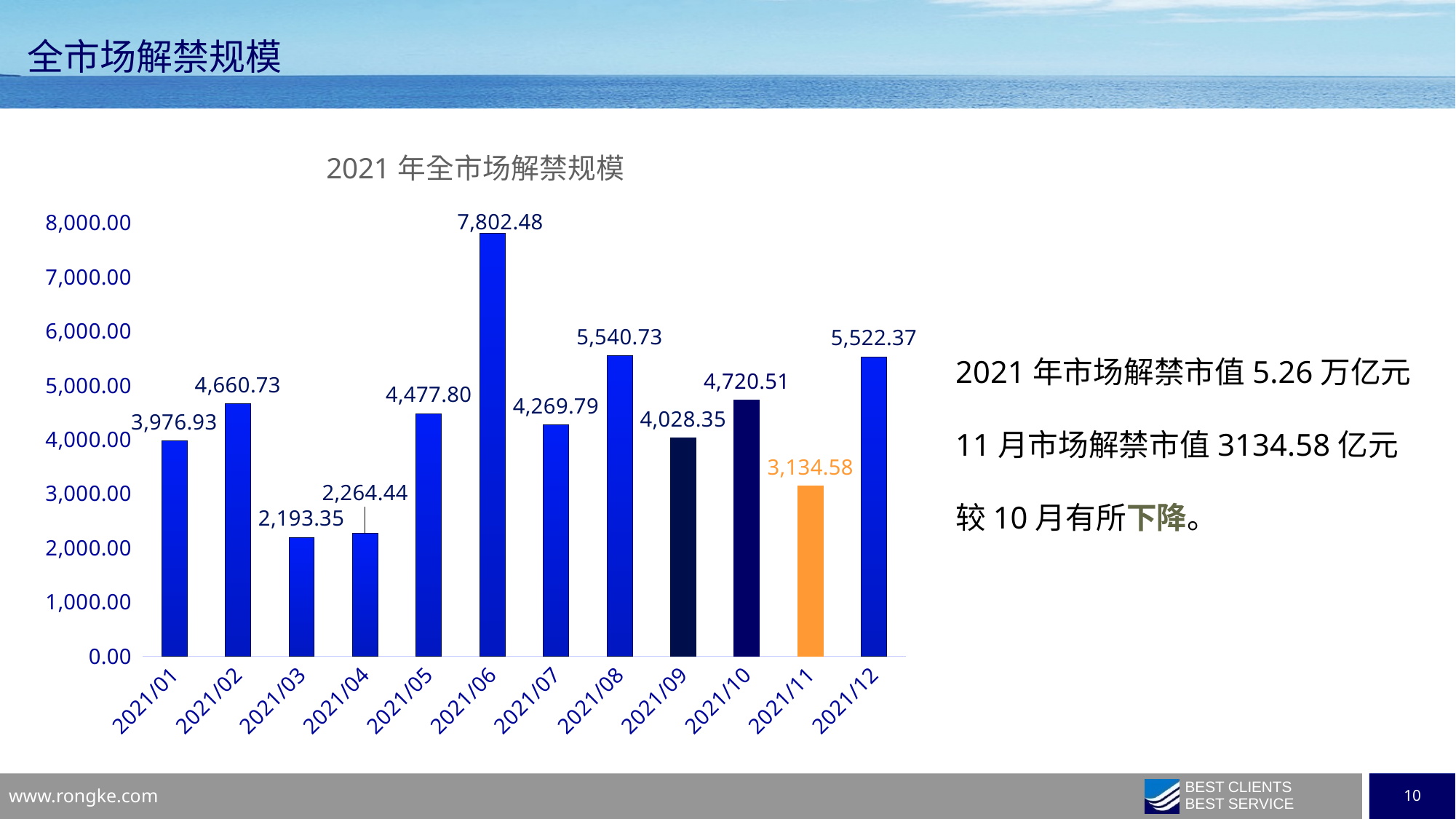
Which month has the highest value? 2021/06 What is the value for 2021/03? 2,193.35 What type of chart is shown on the slide? Bar chart How many months (categories) are plotted in the chart? 12 Which is larger, the value for 2021/02 or the value for 2021/05? 2021/02 What is the value for 2021/11? 3,134.58 What is the difference between the values for 2021/10 and 2021/11? 1,585.93 Which month has the lowest value? 2021/03 What is the value for 2021/06? 7,802.48 What is the title of the chart? 2021 年全市场解禁规模 Which month's bar is coloured orange? 2021/11 Is the value for 2021/08 greater or less than 5,000.00? greater